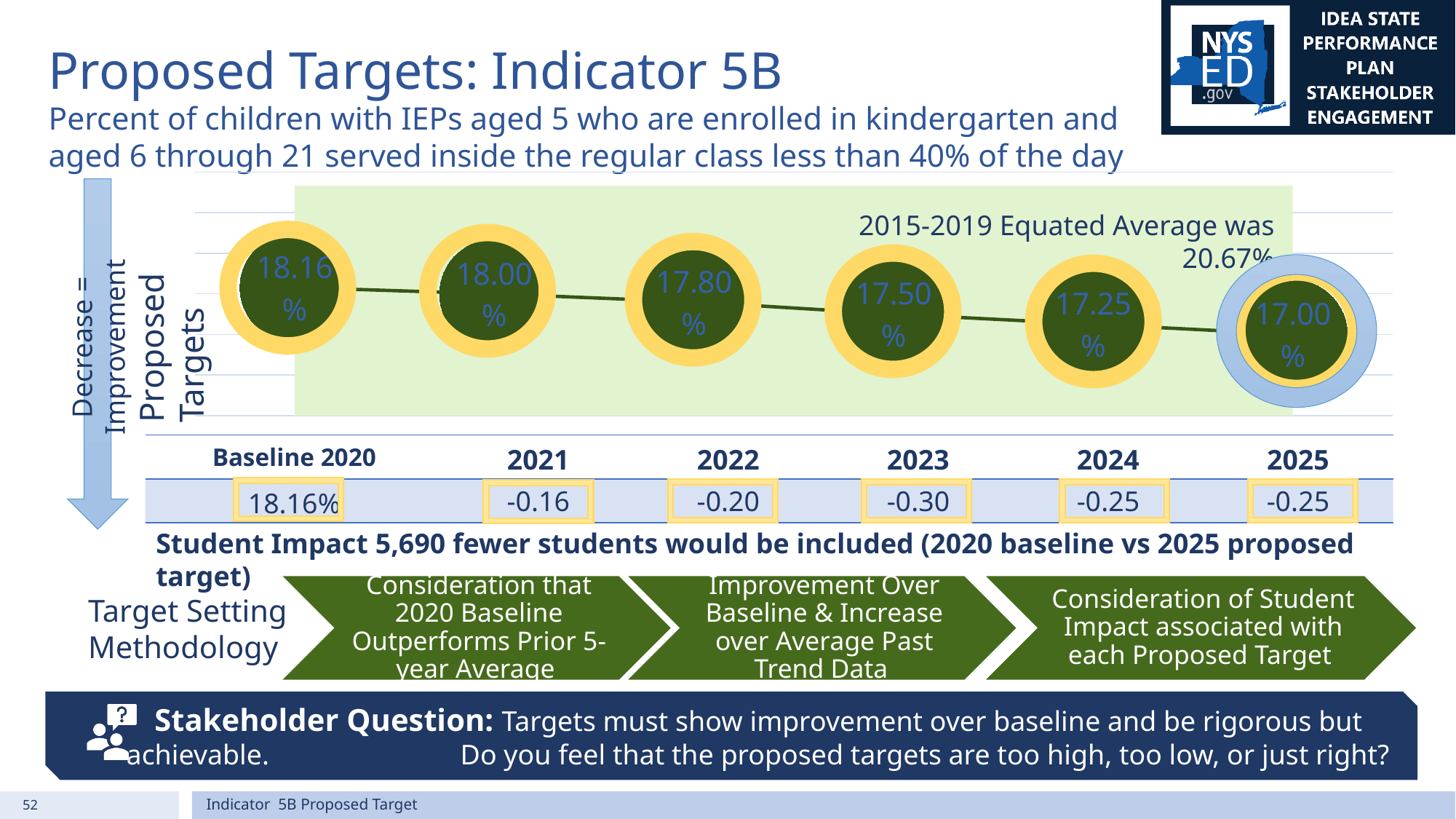
What is the difference between the Baseline 2020 value and the 2025 proposed target? 1.16% What kind of chart is used to show the proposed targets? Line chart Which point on the chart has the highest value? Baseline 2020 What is the proposed target value for 2025? 17.00% What was the 2015-2019 Equated Average stated on the chart? 20.67% Do the proposed target values rise or fall from Baseline 2020 to 2025? Fall What is the proposed target value for 2023? 17.50% What is the year-over-year change shown in the table for 2023? -0.30 Which year has the lowest proposed target value? 2025 How many data points are plotted on the chart? 6 Which is larger, the proposed target for 2022 or for 2024? 2022 What is the Baseline 2020 value shown on the chart? 18.16%